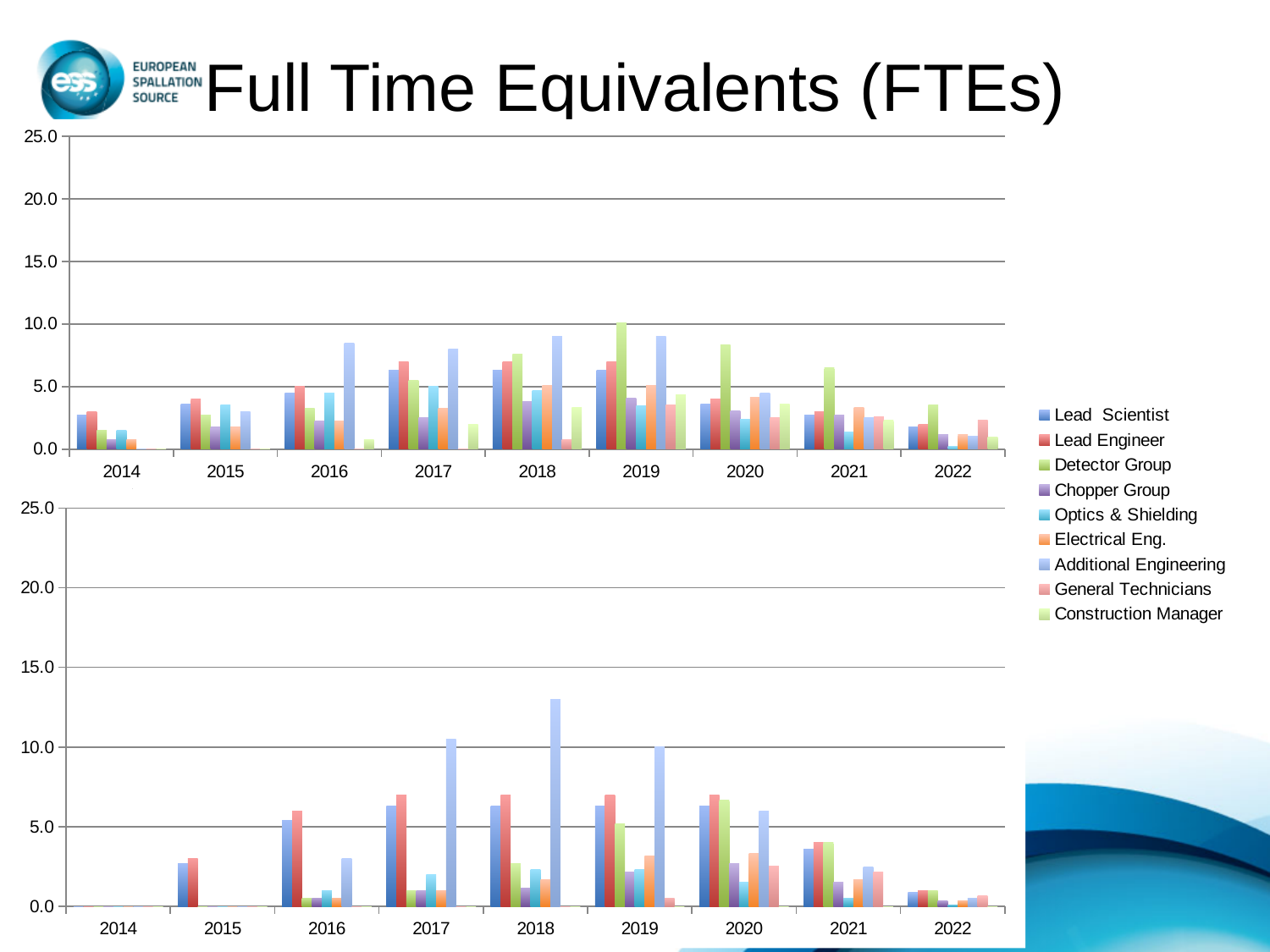
In the bottom chart, is the value for Additional Engineering in 2018 greater or less than 10.0? greater In the top chart, is the value for Additional Engineering in 2016 greater or less than 5.0? greater How many series does the legend list? 9 In the top chart, is the value for Lead Scientist in 2014 greater or less than 5.0? less In the top chart, do the Lead Scientist values rise or fall from 2019 to 2022? fall In the top chart, which is larger in 2016: Additional Engineering or Lead Scientist? Additional Engineering In the bottom chart, which is larger in 2018: Additional Engineering or Lead Engineer? Additional Engineering How many year categories are shown on the x axis of the bottom chart? 9 What kind of chart is the top chart on the slide? bar chart In the bottom chart, which year has the tallest bar? 2018 In the bottom chart, which year shows no bars at all? 2014